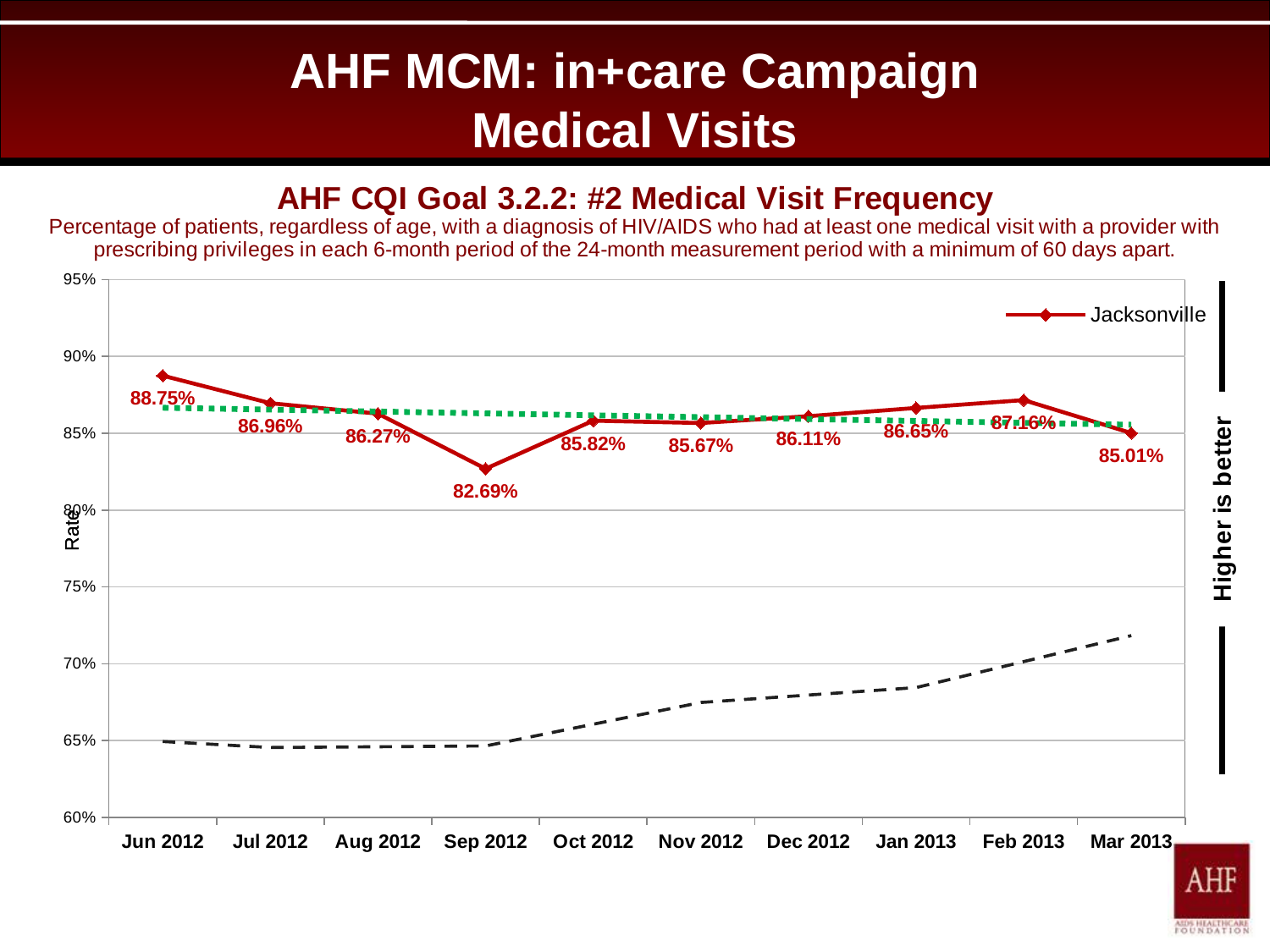
In which month is the Jacksonville value lowest? Sep 2012 In which month is the Jacksonville value highest? Jun 2012 How many series does the legend list? 1 What is the Jacksonville value for Mar 2013? 85.01% How many months are plotted on the x axis? 10 What kind of chart is shown on the slide? line chart What is the difference between the Jacksonville values for Jun 2012 and Sep 2012? 6.06% Which is larger, the Jacksonville value for Jul 2012 or for Aug 2012? Jul 2012 What is the Jacksonville value for Jun 2012? 88.75% What is the Jacksonville value for Sep 2012? 82.69% What is the Jacksonville value for Feb 2013? 87.16% Is the Jacksonville value for Sep 2012 greater or less than 85%? less